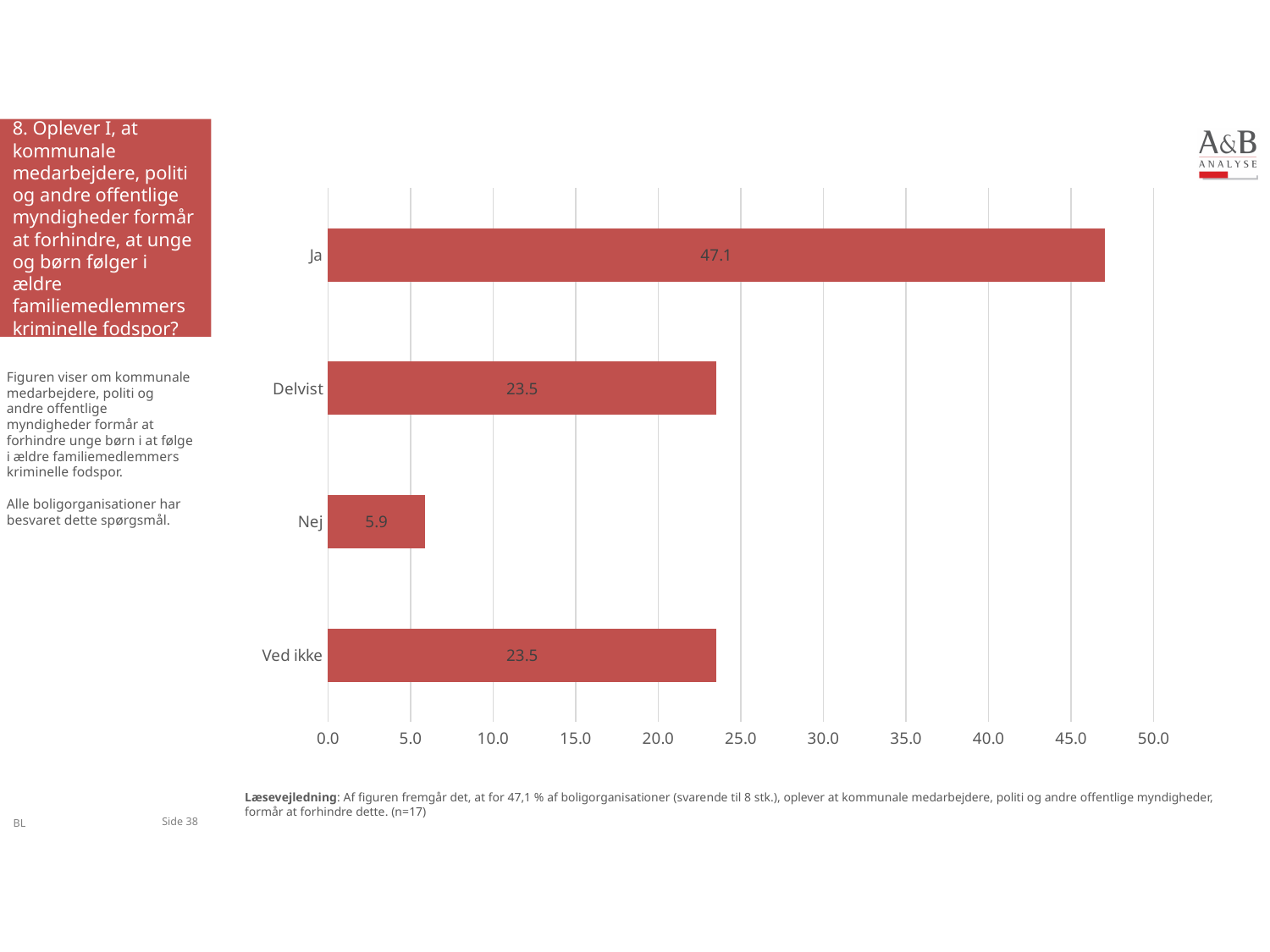
How many categories are shown in the chart? 4 Is the value for "Delvist" greater or less than 20.0? greater What is the difference between the values for "Ved ikke" and "Nej"? 17.6 Which category has the lowest value? Nej What is the value for "Ja"? 47.1 Which category has the highest value? Ja What is the value for "Delvist"? 23.5 What is the highest value shown on the x axis? 50.0 What kind of chart is shown on the slide? Bar chart What is the value for "Nej"? 5.9 What is the difference between the values for "Ja" and "Delvist"? 23.6 Which is larger, the value for "Ja" or the value for "Ved ikke"? Ja